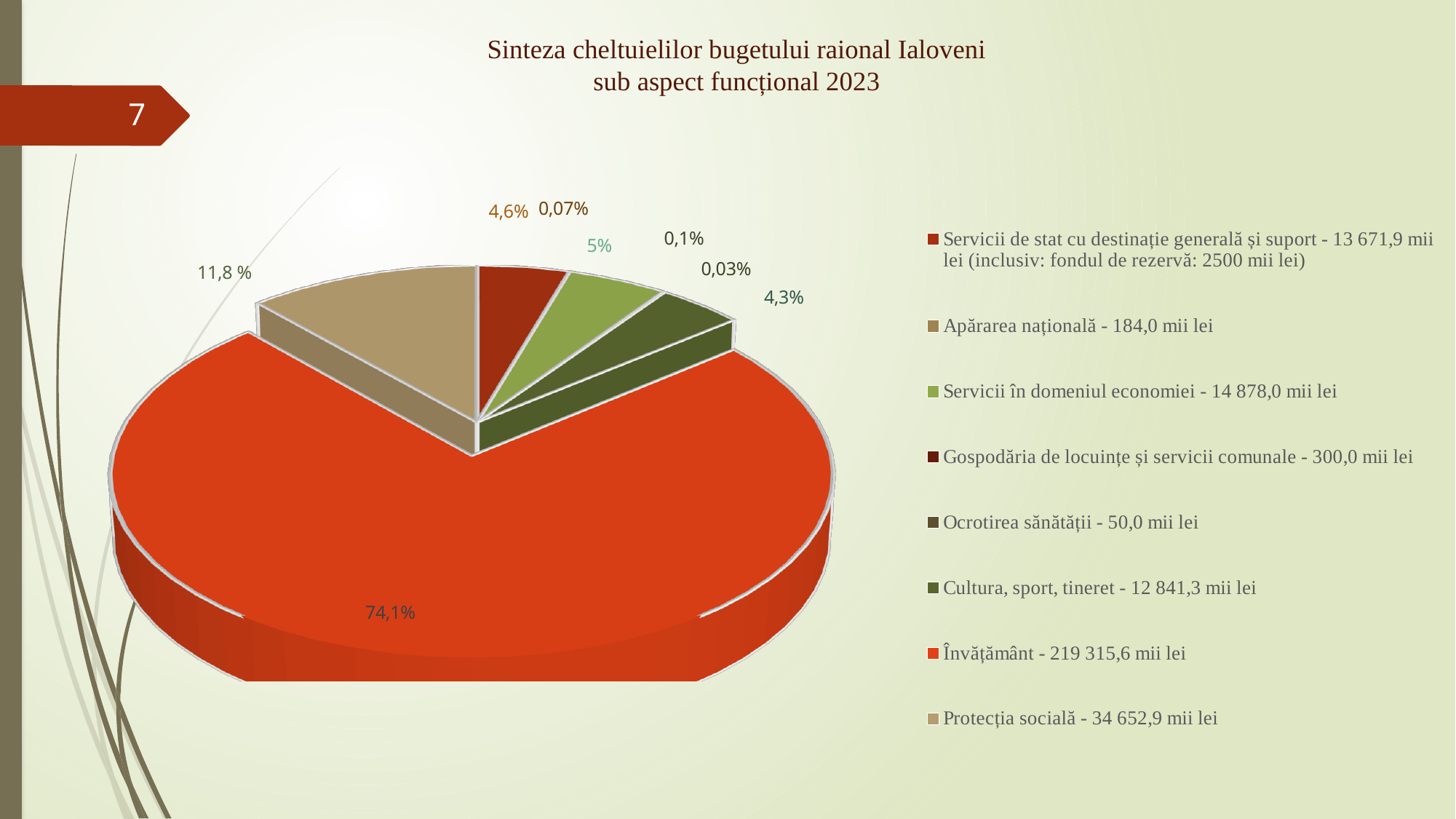
What kind of chart is shown on the slide? pie chart What is the amount shown in the legend for Învățământ? 219 315,6 mii lei What share of the pie does Învățământ represent? 74,1% What is the amount shown in the legend for Apărarea națională? 184,0 mii lei How many categories does the legend of the pie chart list? 8 What is the amount shown in the legend for Cultura, sport, tineret? 12 841,3 mii lei What is the title of the chart? Sinteza cheltuielilor bugetului raional Ialoveni sub aspect funcțional 2023 What colour is the largest slice of the pie? red What is the difference in percentage points between the Învățământ share (74,1%) and the Protecția socială share (11,8 %)? 62,3 Which slice is larger: Protecția socială or Servicii în domeniul economiei? Protecția socială Which category has the largest share of the pie? Învățământ What share of the pie does Protecția socială represent? 11,8 %